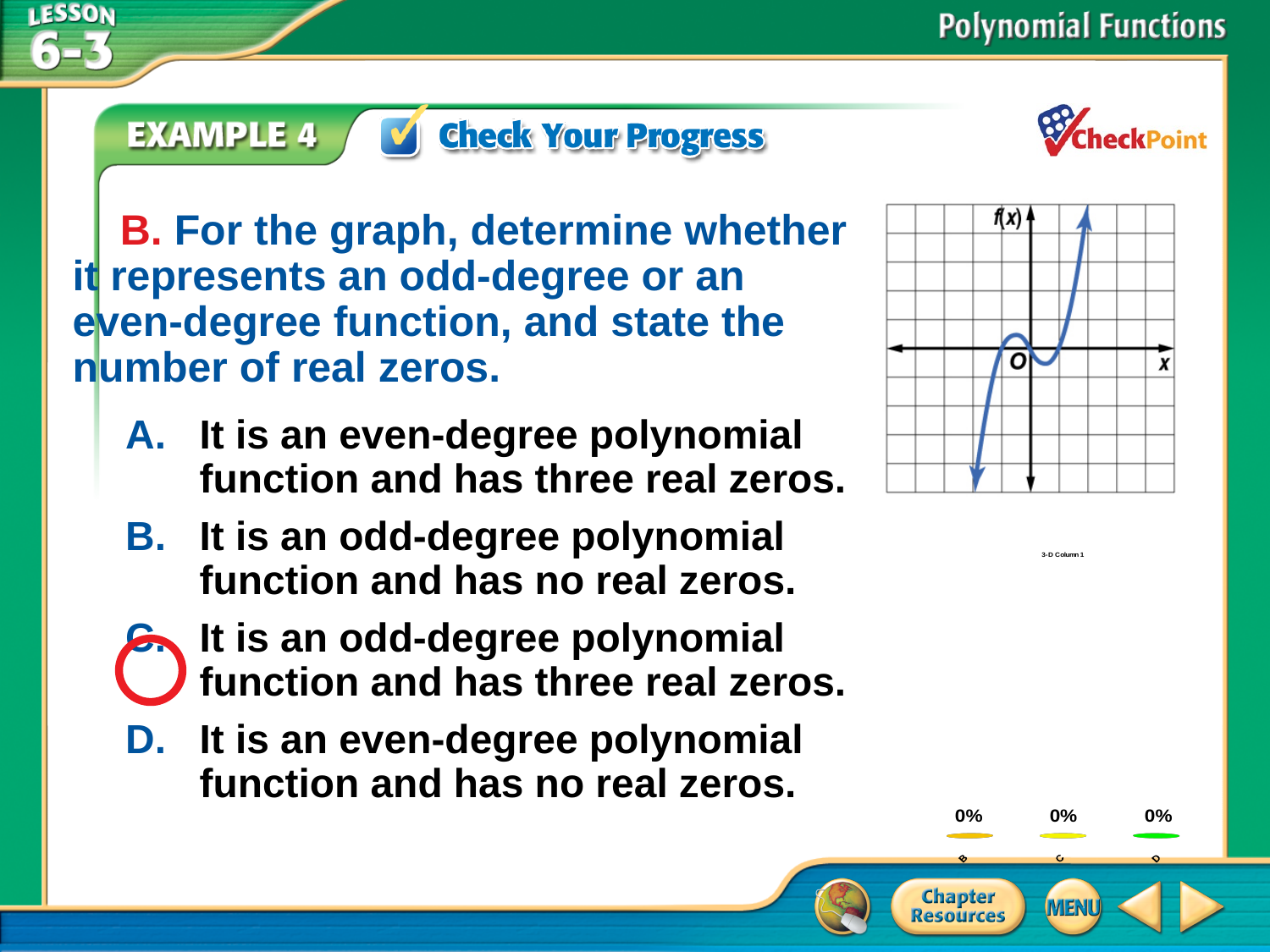
What kind of chart is shown at the bottom right of the slide? bar chart In the bar chart at the bottom right, what value is printed above each visible bar? 0% In the bar chart at the bottom right, how many data labels reading 0% are visible? 3 In the bar chart at the bottom right, is the value of the leftmost visible bar greater than or equal to the value of the rightmost visible bar? equal